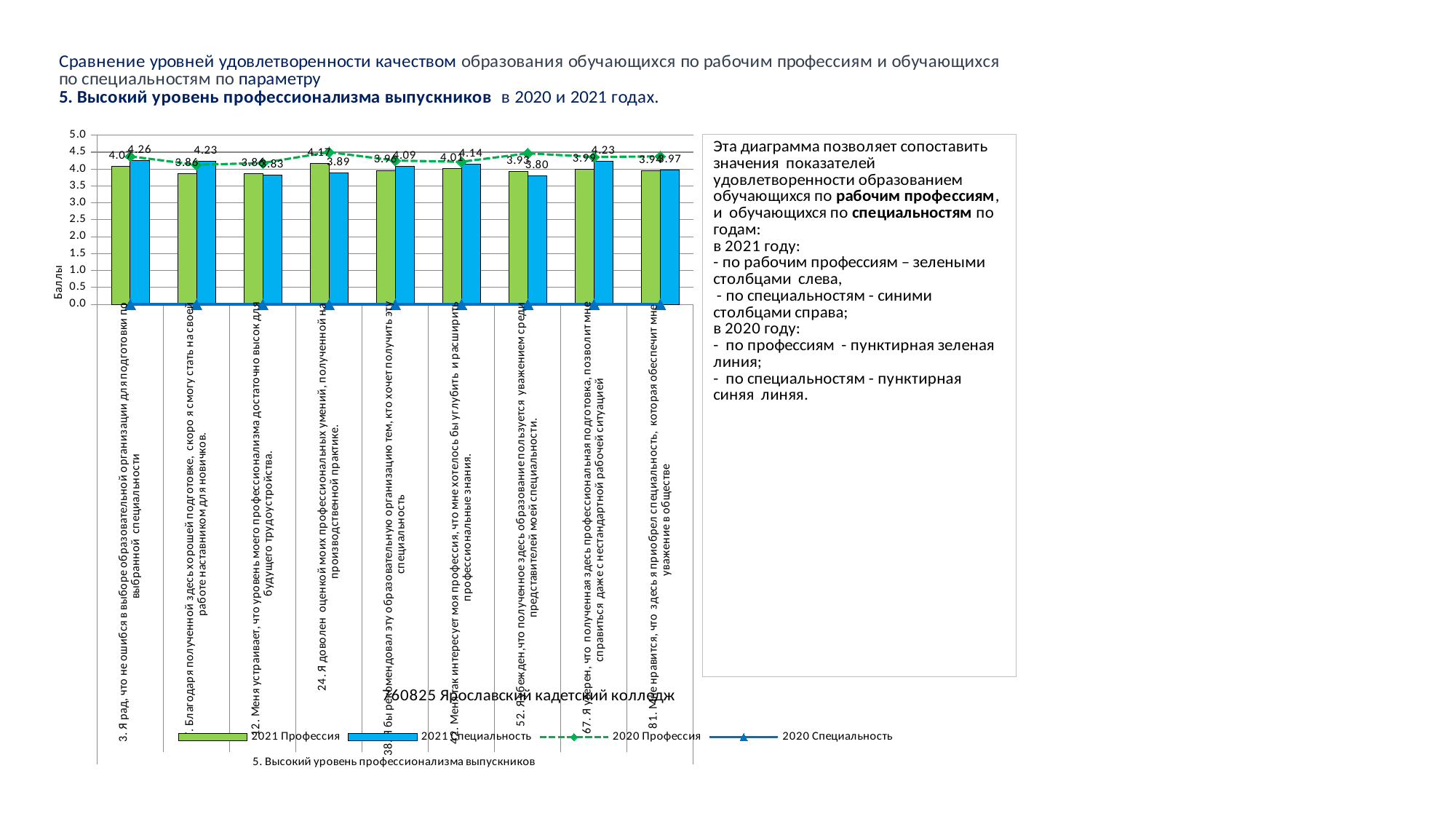
Which statement has the highest 2021 Профессия value? 24. Я доволен оценкой моих профессиональных умений, полученной на производственной практике What is the difference between the 2021 Профессия and 2021 Специальность values for statement 24? 0.28 What is the 2021 Специальность value for statement 67 (Я уверен, что полученная здесь профессиональная подготовка позволит мне справиться даже с нестандартной рабочей ситуацией)? 4.23 For statement 24, which is larger: the 2021 Профессия value or the 2021 Специальность value? 2021 Профессия Is the 2020 Специальность line value for statement 3 greater or less than 0.5? less What kind of chart is shown on the slide? bar chart (with line series) Which series is shown by the green dashed line according to the legend? 2020 Профессия What is the label of the vertical axis? Баллы What is the 2021 Специальность value for statement 24 (Я доволен оценкой моих профессиональных умений, полученной на производственной практике)? 3.89 How many series does the chart legend list? 4 What is the 2021 Профессия value for statement 24 (Я доволен оценкой моих профессиональных умений, полученной на производственной практике)? 4.17 How many categories (statements) are plotted along the x axis? 9